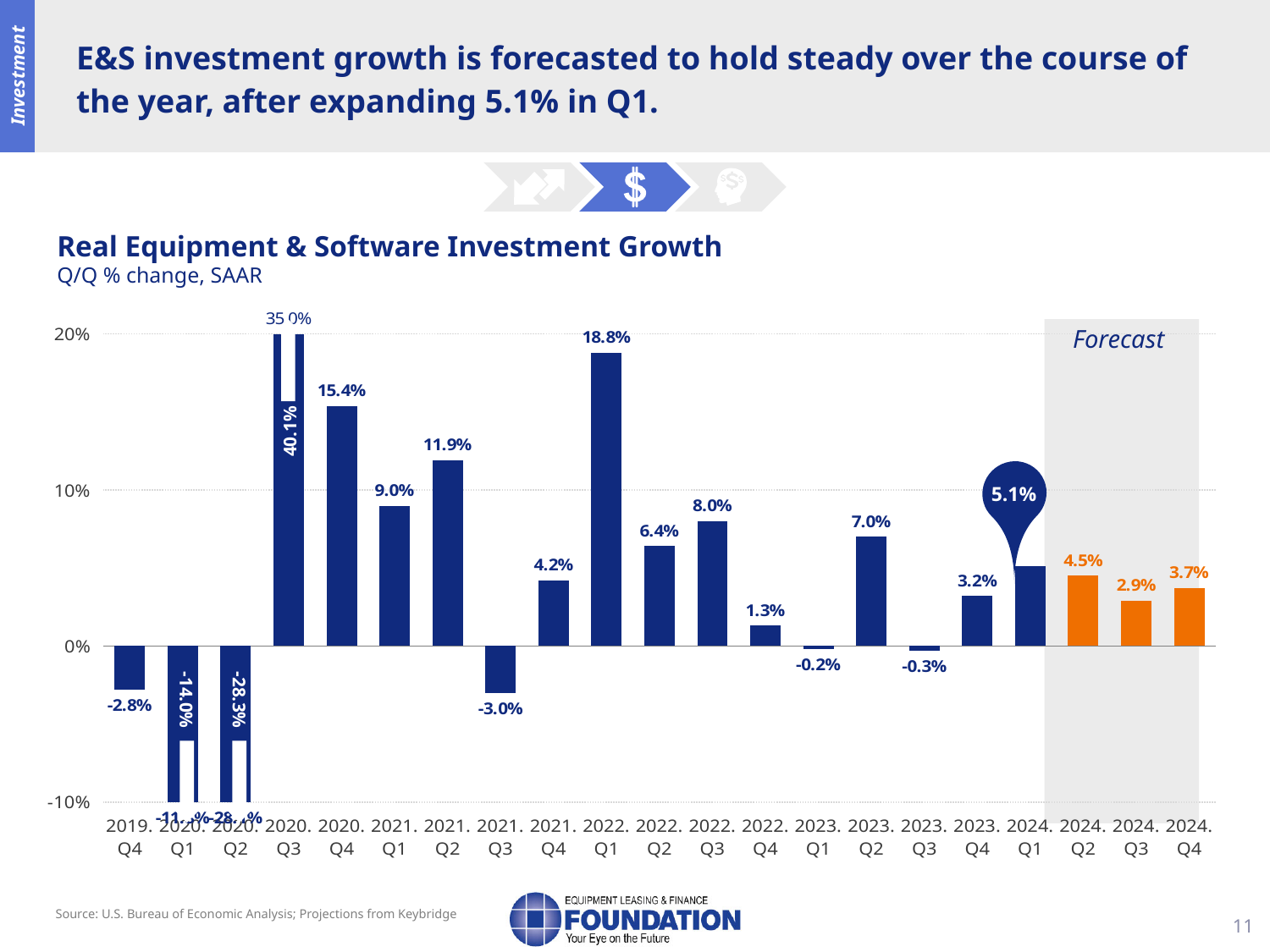
What is the value for 2024 Q1 in the chart? 5.1% What kind of chart is shown on the slide? bar chart Which quarter has the highest value in the chart? 2020 Q3 Is the value for 2020 Q4 greater or less than 10%? greater Do the values rise or fall from 2019 Q4 to 2020 Q2? fall What is the value for 2023 Q2 in the chart? 7.0% What is the value for 2022 Q1 in the Real Equipment & Software Investment Growth chart? 18.8% Which quarter has the lowest value in the chart? 2020 Q2 What is the difference between the values for 2024 Q2 and 2024 Q4? 0.8 percentage points Which is larger, the value for 2022 Q2 or the value for 2022 Q3? 2022 Q3 How many quarters are plotted in the chart? 21 What is the value for 2021 Q3 in the chart? -3.0%